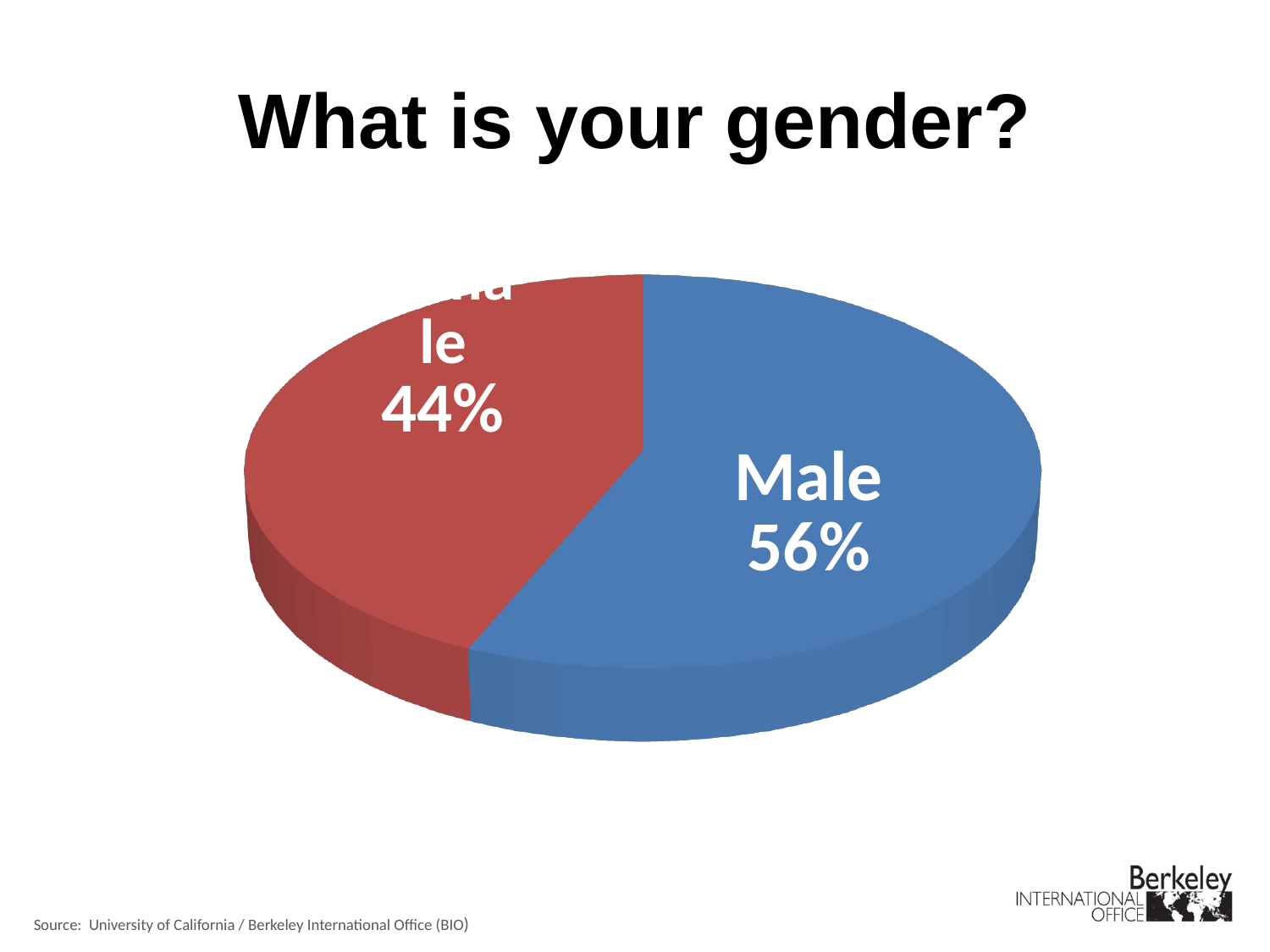
What percentage is shown on the red slice of the pie? 44% What is the title of the chart on the slide? What is your gender? What kind of chart is shown on the slide? pie chart What do the two slice percentages add up to? 100% Which is larger, the Male slice or the red slice? Male How many slices does the pie chart have? 2 What colour is the Male slice? blue Which slice is smaller, the blue slice or the red slice? the red slice Which slice of the pie is the largest? Male Is the Male share greater or less than 50%? greater What percentage of the pie is the Male slice? 56% What is the difference in percentage points between the Male slice and the red slice? 12 percentage points